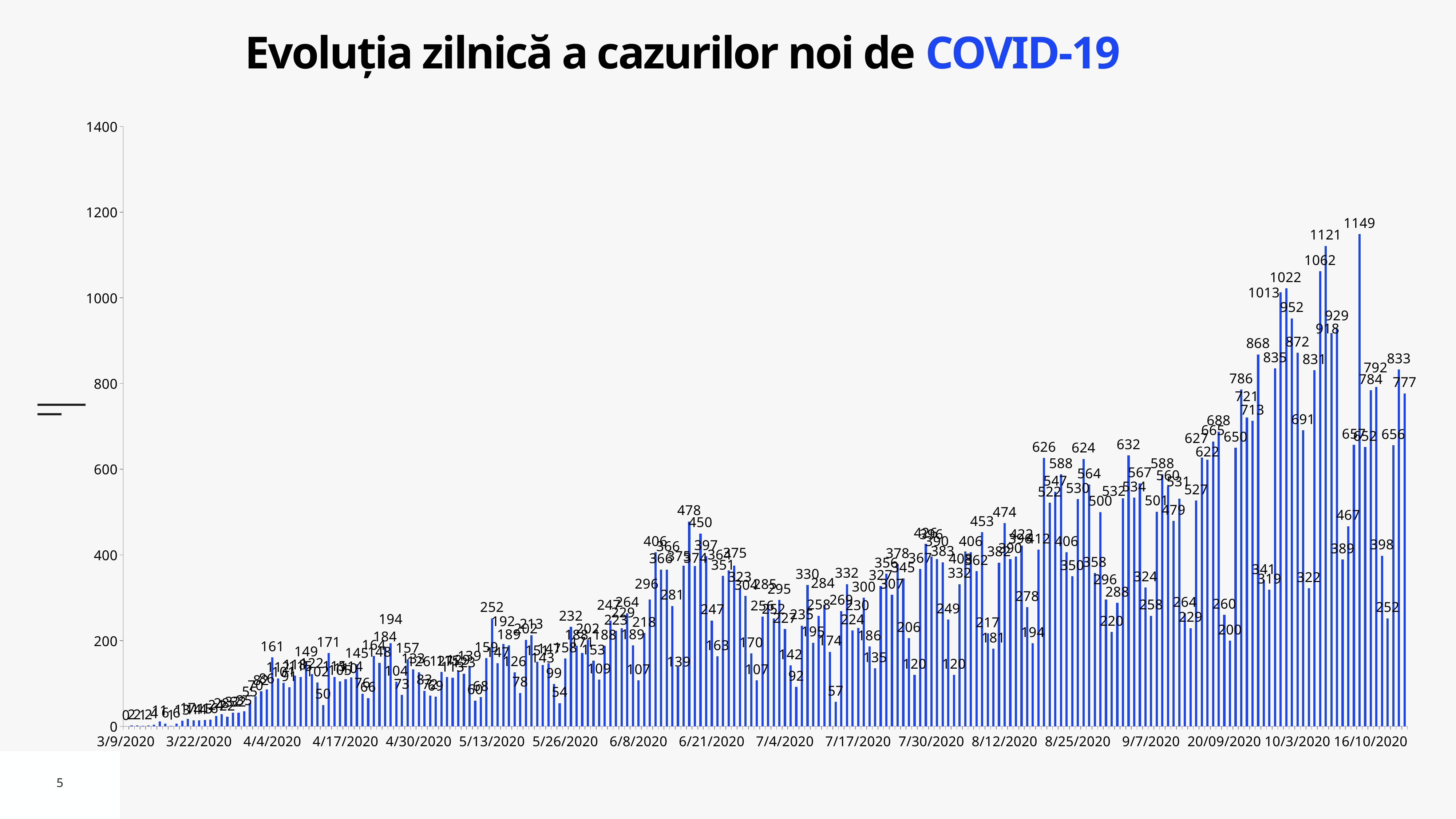
What is the title of the chart? Evoluția zilnică a cazurilor noi de COVID-19 Which is larger, the bar labeled 1062 or the bar labeled 952? 1062 Overall, do the daily values rise or fall from left to right along the x axis? rise What is the second-highest value labeled on the chart? 1121 What is the highest value labeled on the chart? 1149 What is the value of the last bar on the right of the chart? 777 What is the difference between the highest value (1149) and the last bar's value (777)? 372 What is the difference between the highest value (1149) and the second-highest value (1121)? 28 What is the value of the first bar, at 3/9/2020? 0 Is the highest bar on the chart greater or less than 1000? greater What is the maximum value shown on the vertical axis? 1400 What kind of chart is shown on the slide? bar chart